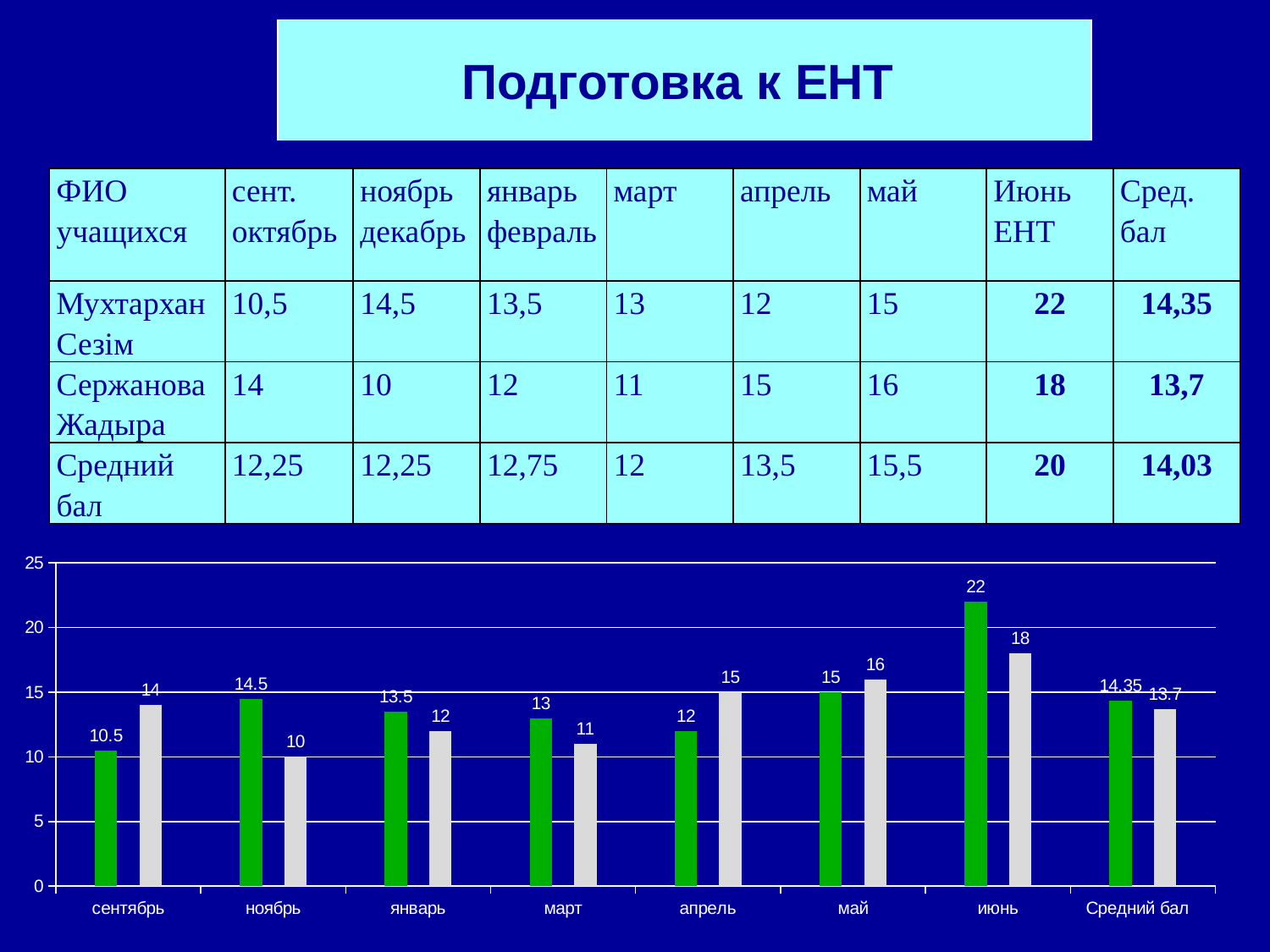
How many categories are shown on the x axis? 8 What kind of chart is shown on the slide? bar chart What is the value of the green bar for сентябрь? 10.5 What is the value of the grey bar for Средний бал? 13.7 Is the green bar for июнь greater or less than 20? greater Which category has the lowest grey bar? ноябрь Which category has the highest green bar? июнь Which is larger for май, the green bar or the grey bar? the grey bar What is the title of the slide? Подготовка к ЕНТ What is the value of the grey bar for ноябрь? 10 What is the difference between the green and grey bars for июнь? 4 What is the value of the green bar for июнь? 22